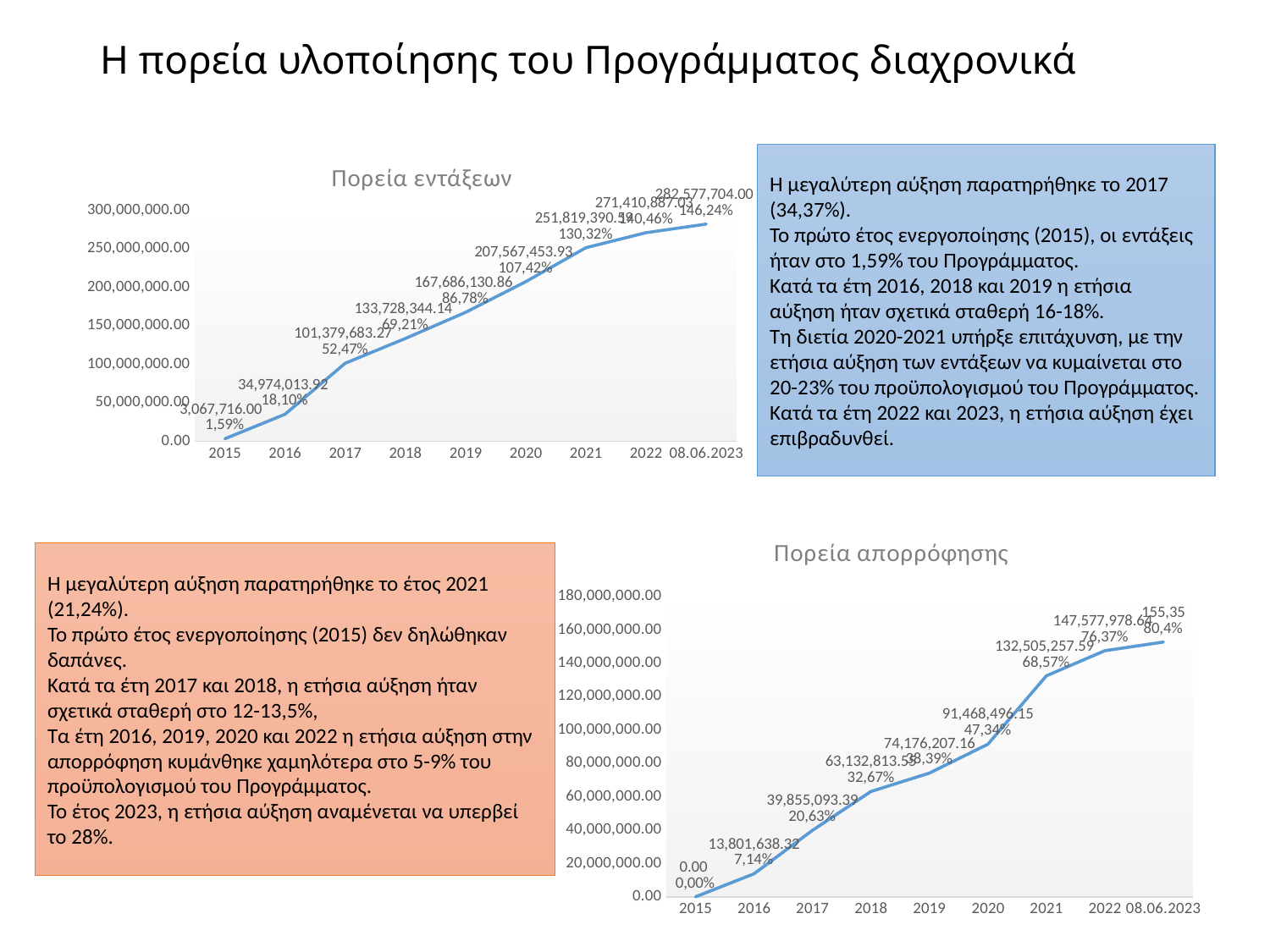
What kind of chart is the 'Πορεία εντάξεων' chart? line chart In the 'Πορεία εντάξεων' chart, what is the difference between the values for 2018 and 2017? 32,348,660.87 In the 'Πορεία απορρόφησης' chart, what percentage is shown for 2021? 68,57% In the 'Πορεία εντάξεων' chart, what is the value for 2019? 167,686,130.86 In the 'Πορεία εντάξεων' chart, what percentage is shown for 2015? 1,59% In the 'Πορεία εντάξεων' chart, what is the value for 2017? 101,379,683.27 In the 'Πορεία απορρόφησης' chart, which is larger, the value for 2018 or the value for 2017? 2018 In the 'Πορεία απορρόφησης' chart, what is the value for 2020? 91,468,496.15 In the 'Πορεία εντάξεων' chart, do the values rise or fall from 2015 to 08.06.2023? rise In the 'Πορεία εντάξεων' chart, how many data points are plotted along the x axis? 9 In the 'Πορεία απορρόφησης' chart, is the value for 2019 greater or less than 80,000,000.00? less In the 'Πορεία απορρόφησης' chart, which year has the lowest value? 2015